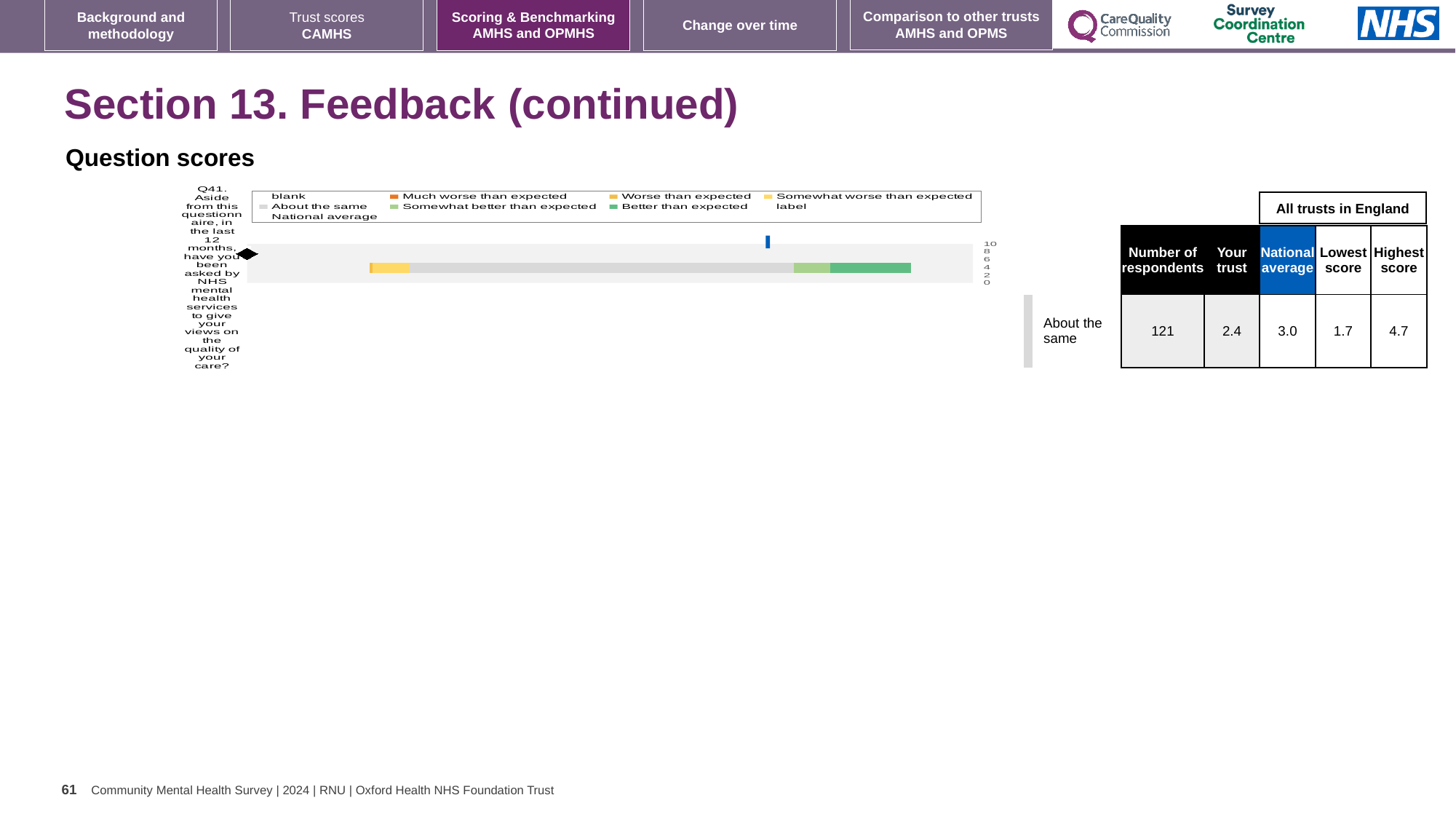
In the table beside the chart, what is the 'Your trust' score for Q41? 2.4 How many questions (categories) are plotted in the chart? 1 What benchmark category is the trust's Q41 result labelled as next to the chart? About the same Which legend entry is shown in orange in the chart? Much worse than expected How many entries does the chart's legend list? 9 What is the difference between the Highest score and the Lowest score for Q41 in the table beside the chart? 3.0 In the table beside the chart, what is the Number of respondents for Q41? 121 Which is larger for Q41: the 'Your trust' score or the National average? National average In the table beside the chart, what is the Highest score among all trusts in England for Q41? 4.7 What kind of chart is shown on the slide for Q41? bar chart In the table beside the chart, what is the National average score for Q41? 3.0 Which legend entry is shown in dark green in the chart? Better than expected